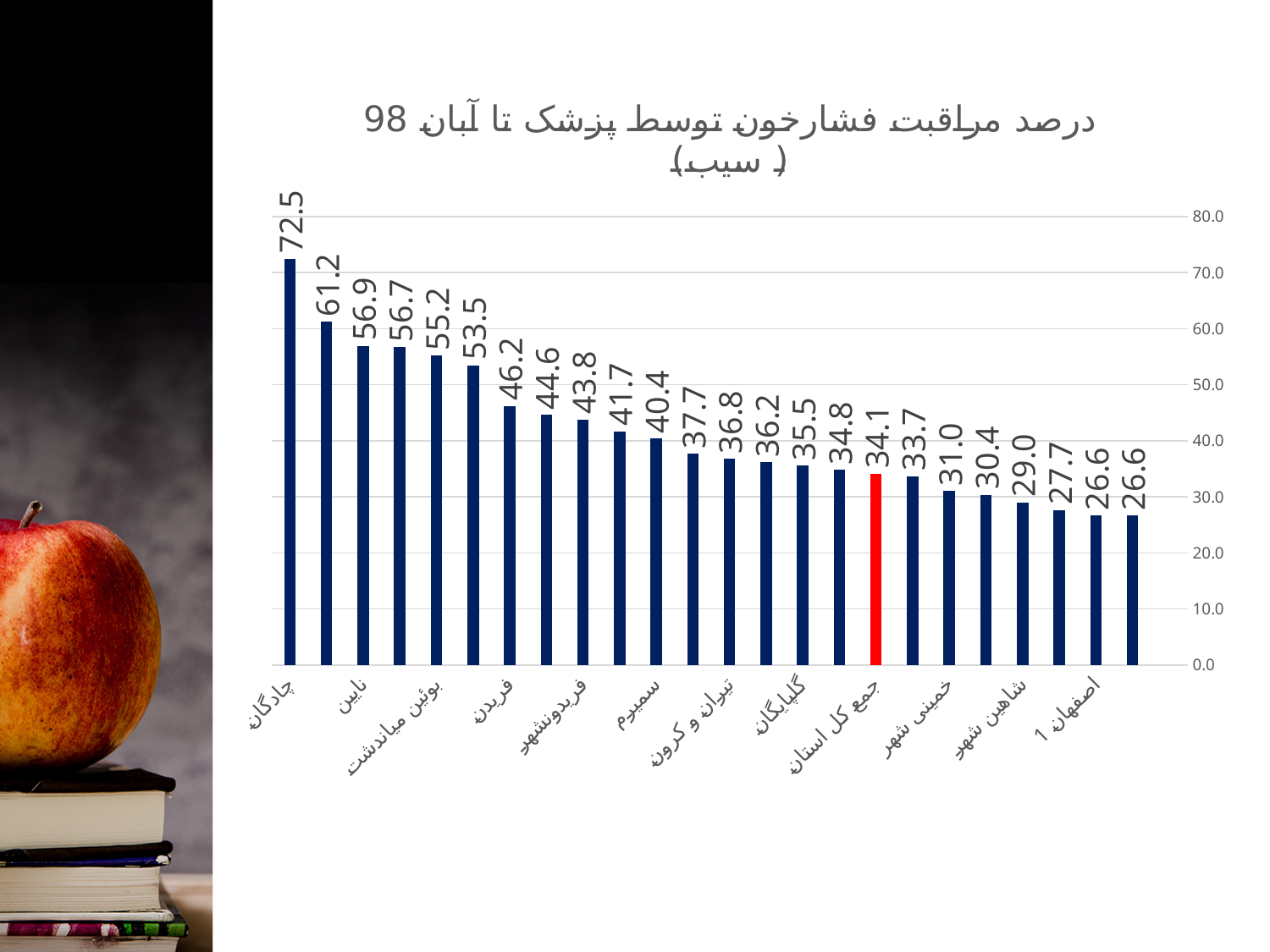
Do the values rise or fall from left to right along the x axis? fall Which category has the highest value? چادگان What is the value for جمع کل استان (the red bar)? 34.1 What is the value for چادگان? 72.5 How many bars are plotted in the chart? 24 What is the lowest value shown in the chart? 26.6 What is the value for نایین? 56.9 What is the value for سمیرم? 40.4 What type of chart is shown on the slide? bar chart What is the value for خمینی شهر? 31.0 What is the difference between the values for چادگان and جمع کل استان? 38.4 Which has a larger value, فریدن or گلپایگان? فریدن